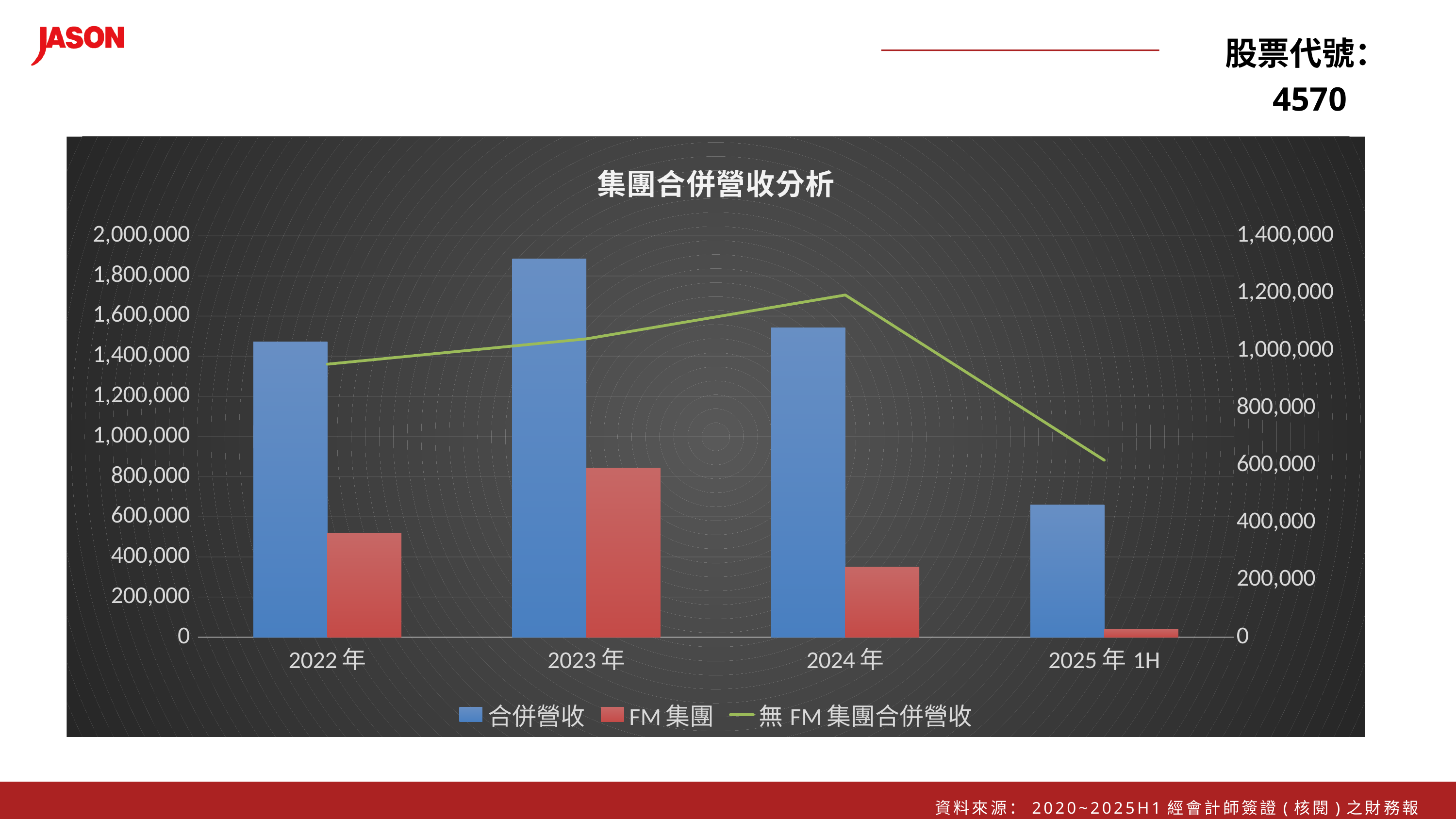
Which is larger, FM 集團 in 2022 年 or FM 集團 in 2024 年? 2022 年 In which year is 合併營收 the highest? 2023 年 How many categories are shown on the x axis of the chart? 4 Does the 無 FM 集團合併營收 line rise or fall from 2022 年 to 2024 年? rise Is the value of 合併營收 for 2022 年 greater or less than 1,200,000? greater In which year is FM 集團 the highest? 2023 年 Is the value of 合併營收 for 2023 年 greater or less than 1,800,000? greater What kind of chart is shown on the slide? A combined bar and line chart Is the value of FM 集團 for 2024 年 greater or less than 400,000? less In which period is 合併營收 the lowest? 2025 年 1H How many series does the legend list? 3 In which period is FM 集團 the lowest? 2025 年 1H